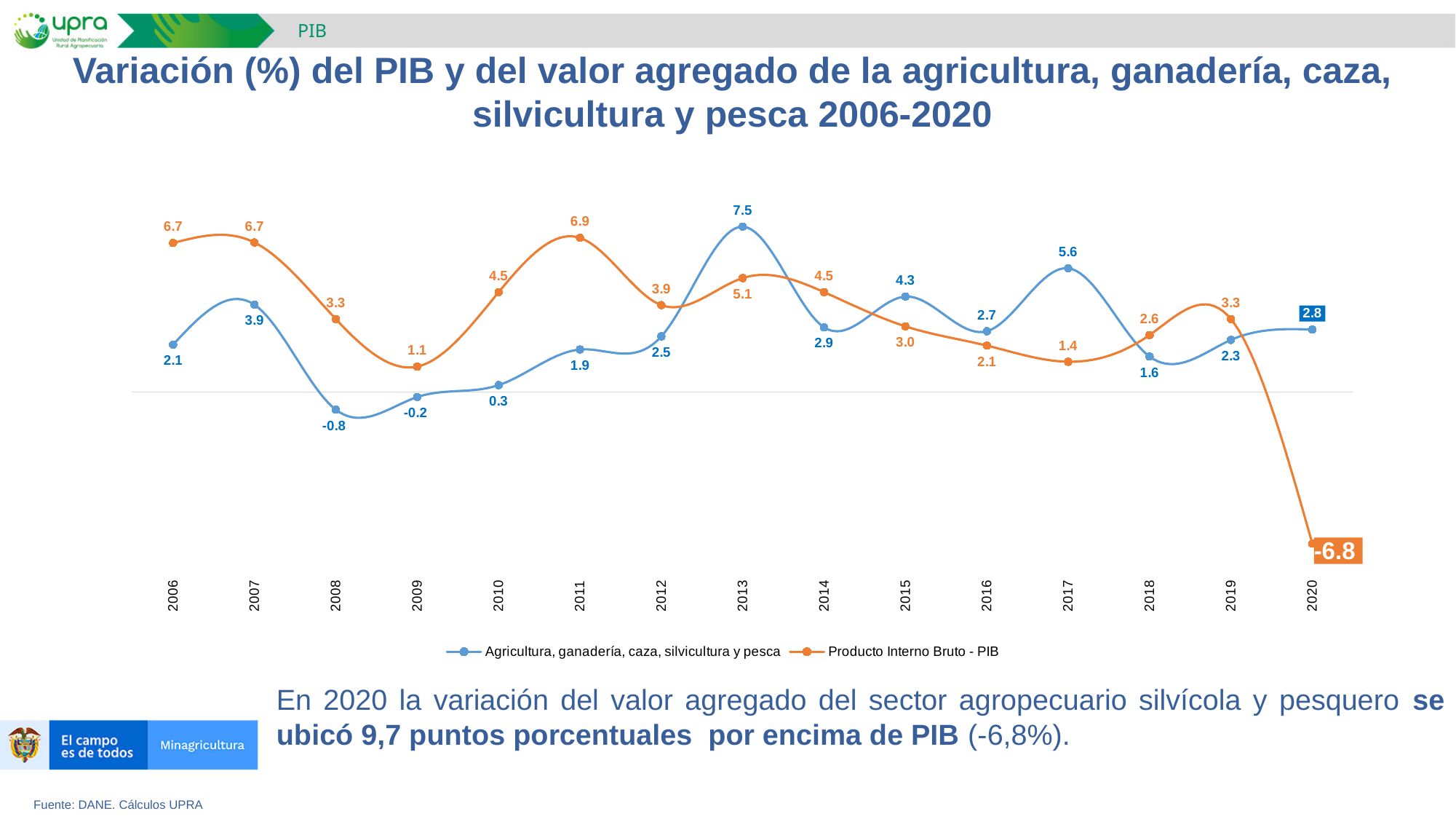
What is the value for Agricultura, ganadería, caza, silvicultura y pesca in 2008? -0.8 Which series has the higher value in 2017, Agricultura or PIB? Agricultura, ganadería, caza, silvicultura y pesca How many series does the legend list? 2 What is the value for Producto Interno Bruto - PIB in 2020? -6.8 In which year does the Agricultura, ganadería, caza, silvicultura y pesca series reach its highest value? 2013 Does the PIB series rise or fall from 2019 to 2020? Fall What is the difference between the Agricultura series and the PIB series in 2020? 9.6 What is the value for Producto Interno Bruto - PIB in 2011? 6.9 How many years are shown on the x axis? 15 In which year does the Producto Interno Bruto - PIB series reach its lowest value? 2020 What is the value for Agricultura, ganadería, caza, silvicultura y pesca in 2013? 7.5 What kind of chart is shown on the slide? Line chart